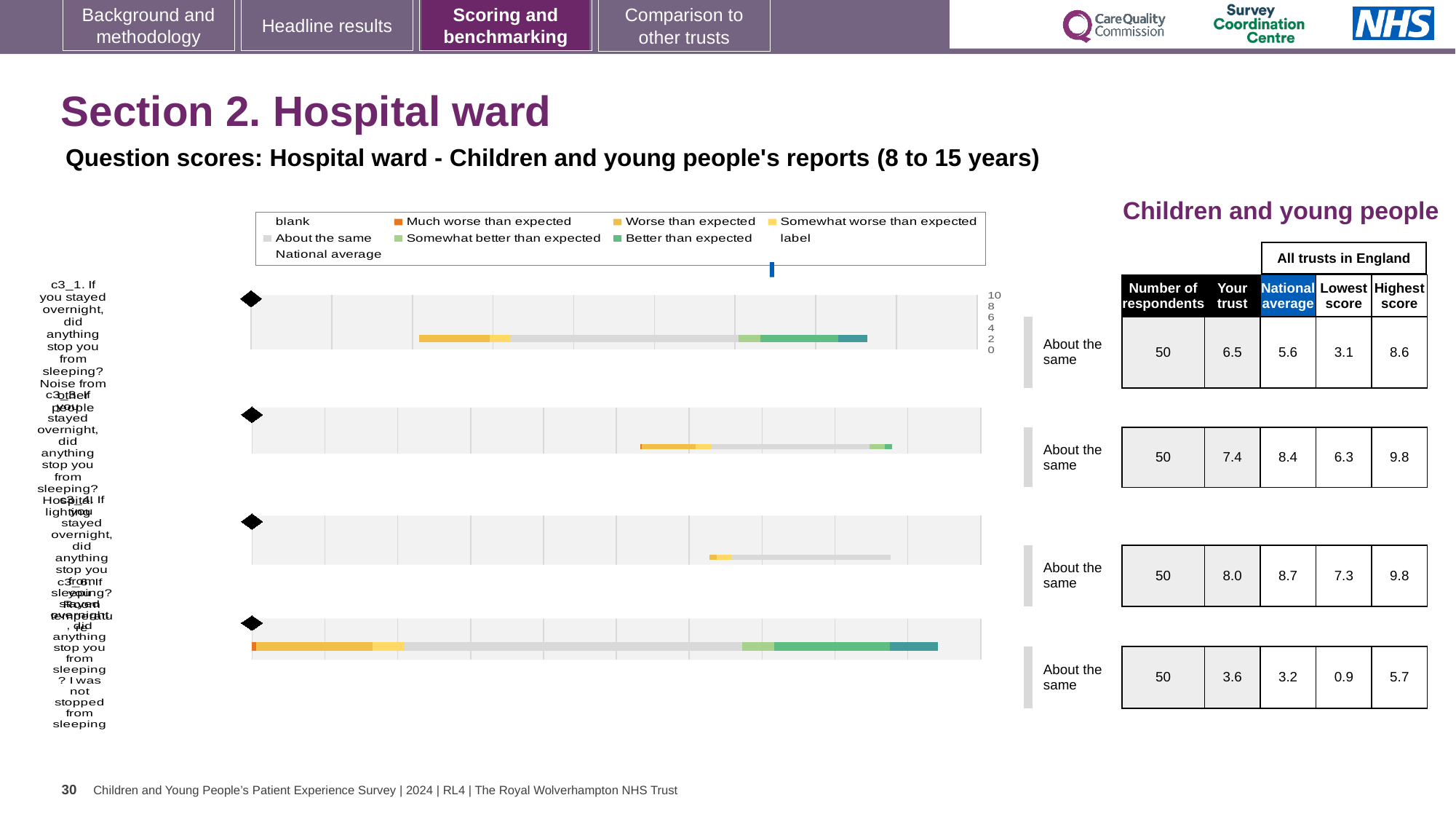
In the legend, what colour represents 'Much worse than expected'? orange How many benchmark bar charts are shown on the slide? 4 For the first chart (c3_1, noise from other people), what is the national average shown in the table? 5.6 How many respondents are listed for the first chart (c3_1, noise from other people)? 50 For the fourth (bottom) chart, what is the national average shown in the table? 3.2 For the fourth (bottom) chart, what is the difference between the highest score and the lowest score in the table? 4.8 For the first chart (c3_1, noise from other people), what is the 'Your trust' score shown in the table? 6.5 How many entries does the legend above the charts list? 9 What kind of chart is used for the four benchmark charts on this slide? bar chart What is the highest tick value shown on the charts' axis? 10 For the first chart (c3_1, noise from other people), which is larger: the 'Your trust' score or the national average? Your trust Which of the four charts has the highest 'Your trust' score in the table? the third chart (8.0)